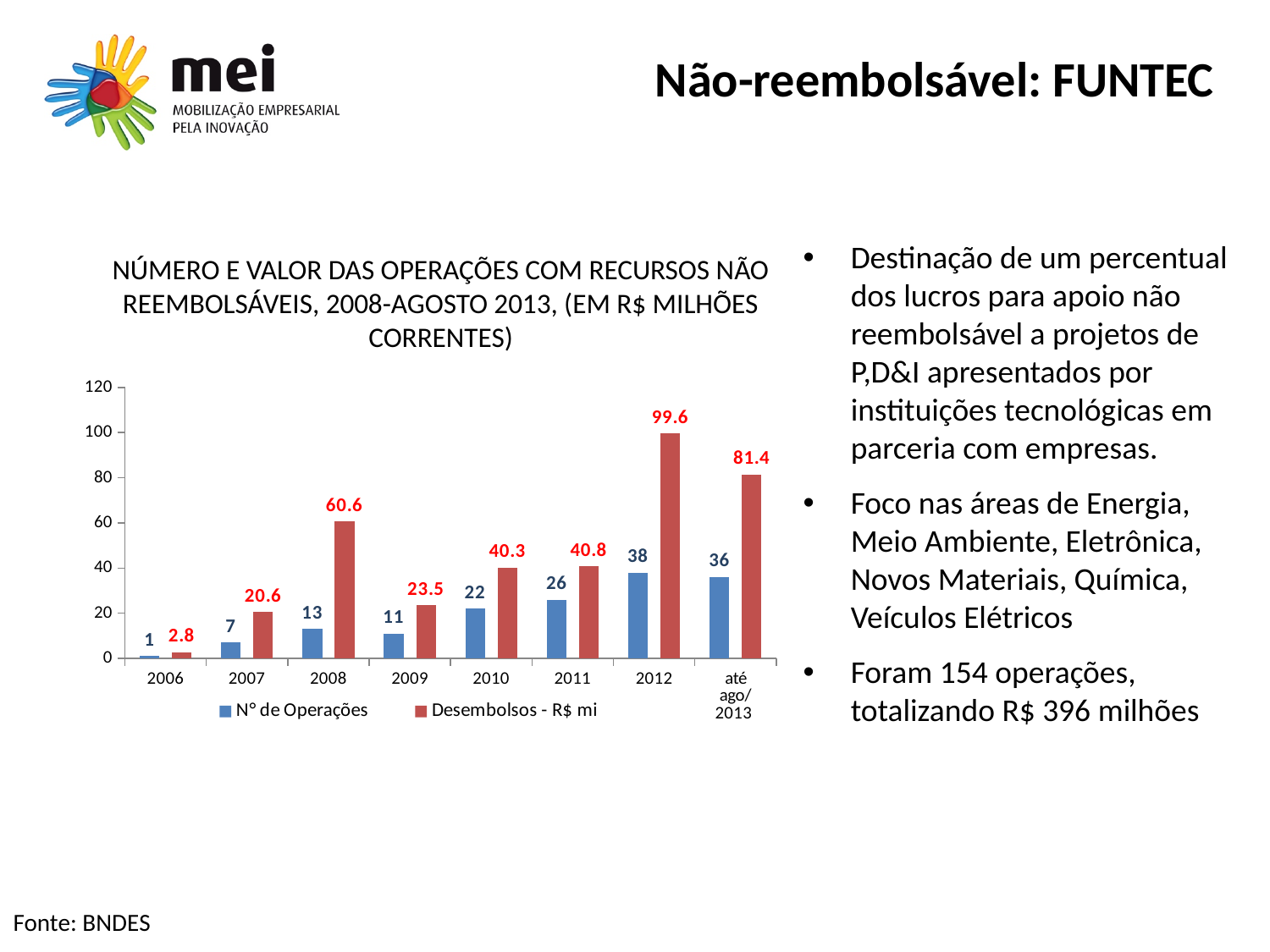
How many categories are shown on the x axis? 8 What kind of chart is shown on the slide? bar chart Which year has the highest Desembolsos - R$ mi? 2012 What is the difference in Desembolsos - R$ mi between 2012 and até ago/2013? 18.2 What is the value of Desembolsos - R$ mi for 2008? 60.6 What is the N° de Operações for 2011? 26 What colour are the Desembolsos - R$ mi bars? red What is the value of Desembolsos - R$ mi for 2012? 99.6 Is the value of Desembolsos - R$ mi for 2010 greater or less than 60? less Which year has the lowest N° de Operações? 2006 Which is larger, the N° de Operações in 2012 or in até ago/2013? 2012 How many series does the legend list? 2